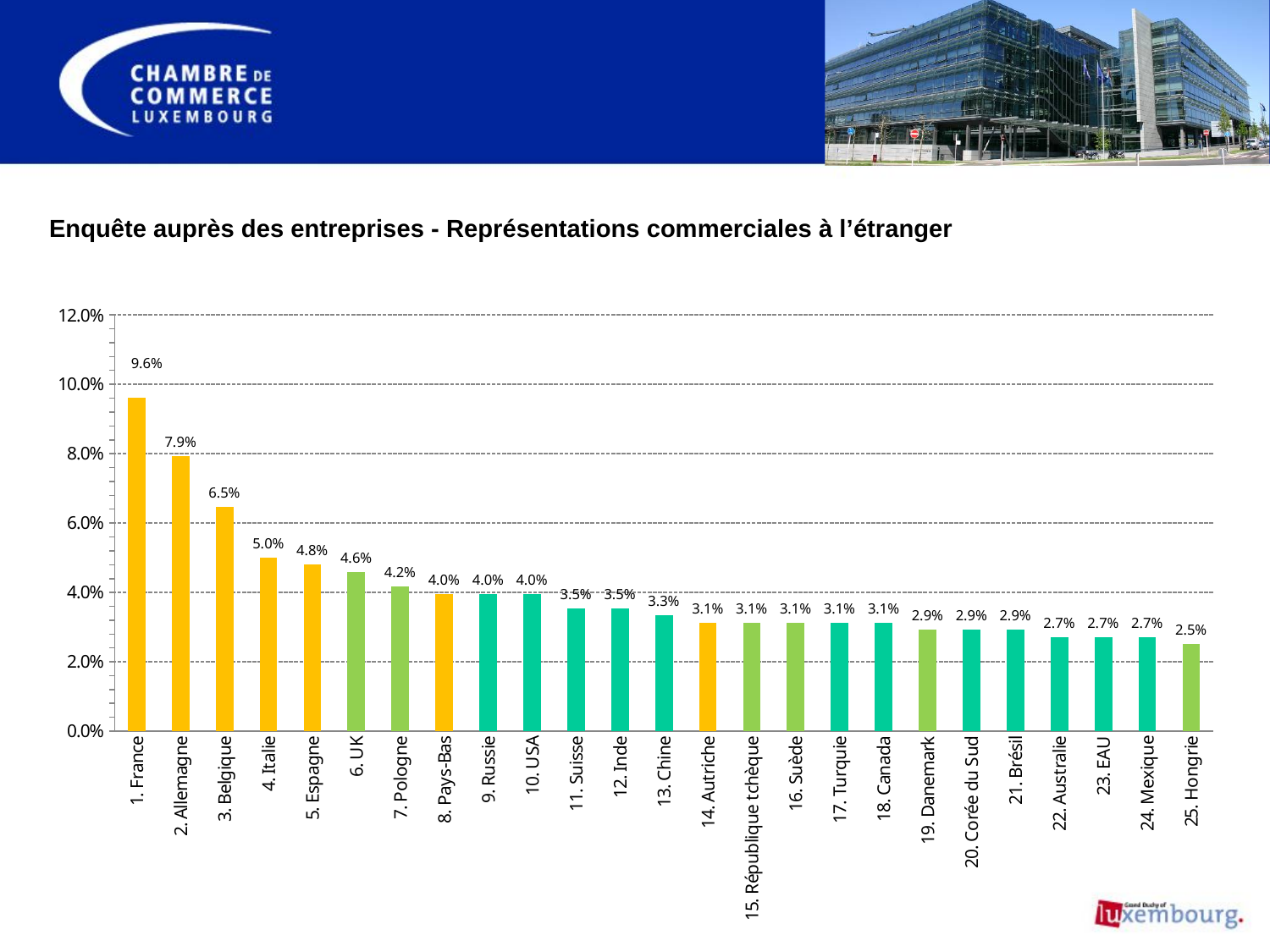
Which category has the highest value? 1. France Which is larger, the value for 4. Italie or the value for 6. UK? 4. Italie Which category has the lowest value? 25. Hongrie What is the value for 13. Chine? 3.3% What is the difference between the values for 1. France and 2. Allemagne? 1.7% What is the value for 1. France? 9.6% What kind of chart is shown on the slide? bar chart What is the value for 25. Hongrie? 2.5% How many categories are shown on the x axis? 25 What is the value for 3. Belgique? 6.5% Do the values rise or fall from left to right along the x axis? fall Is the value for 2. Allemagne greater or less than 8.0%? less